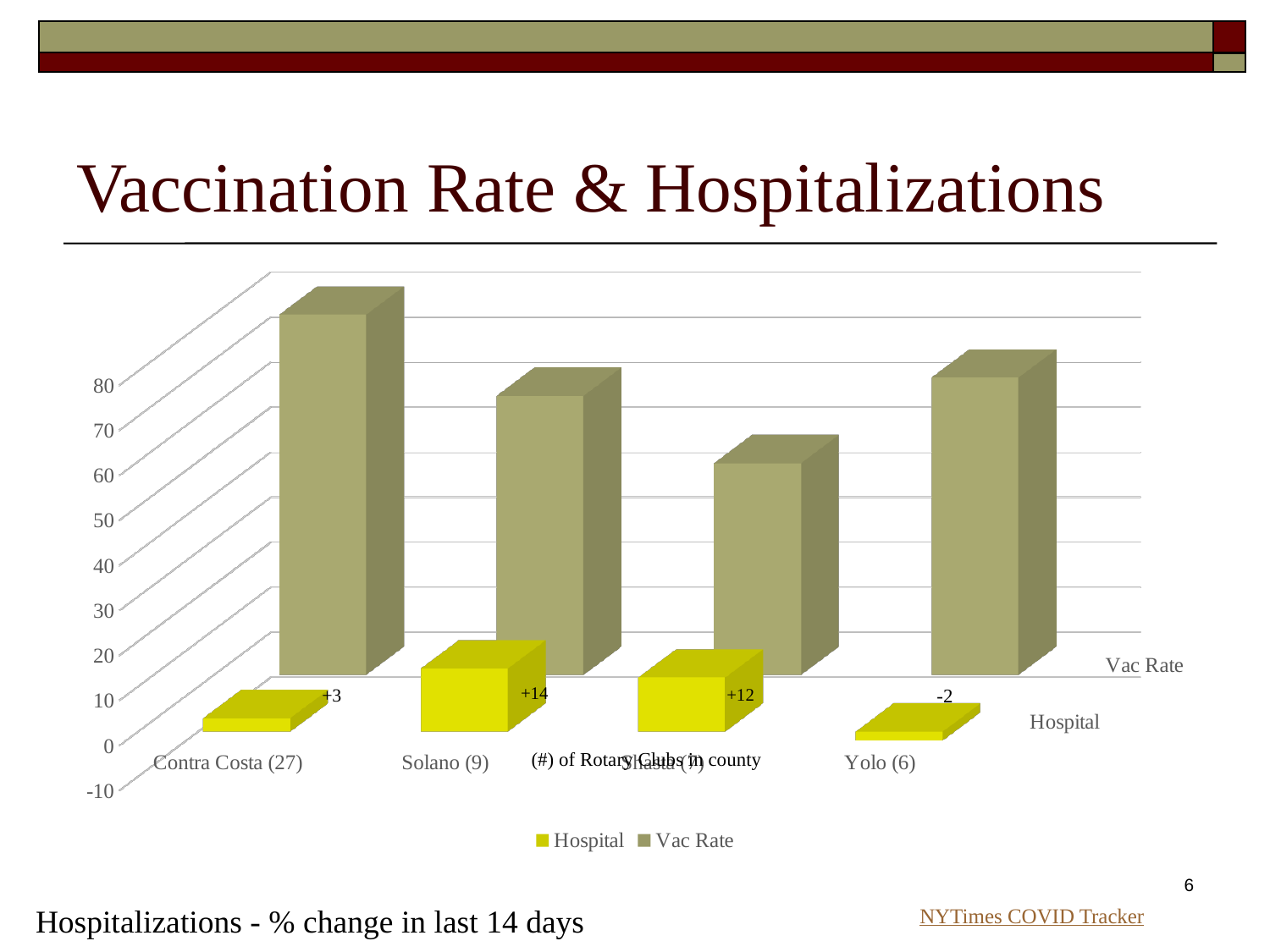
What is the Hospital value for Contra Costa (27)? +3 What is the difference between the Hospital values for Solano (9) and Contra Costa (27)? 11 What is the Hospital value for Yolo (6)? -2 Which county has the highest Vac Rate bar? Contra Costa (27) What type of chart is shown on the slide? Bar chart What is the Hospital value for Solano (9)? +14 How many series does the legend list? 2 Which is larger, the Hospital value for Contra Costa (27) or for Solano (9)? Solano (9) How many counties are shown on the x axis? 4 Which county has the highest Hospital value? Solano (9) Is the Vac Rate value for Contra Costa (27) greater or less than 70? greater Which county has the lowest Hospital value? Yolo (6)